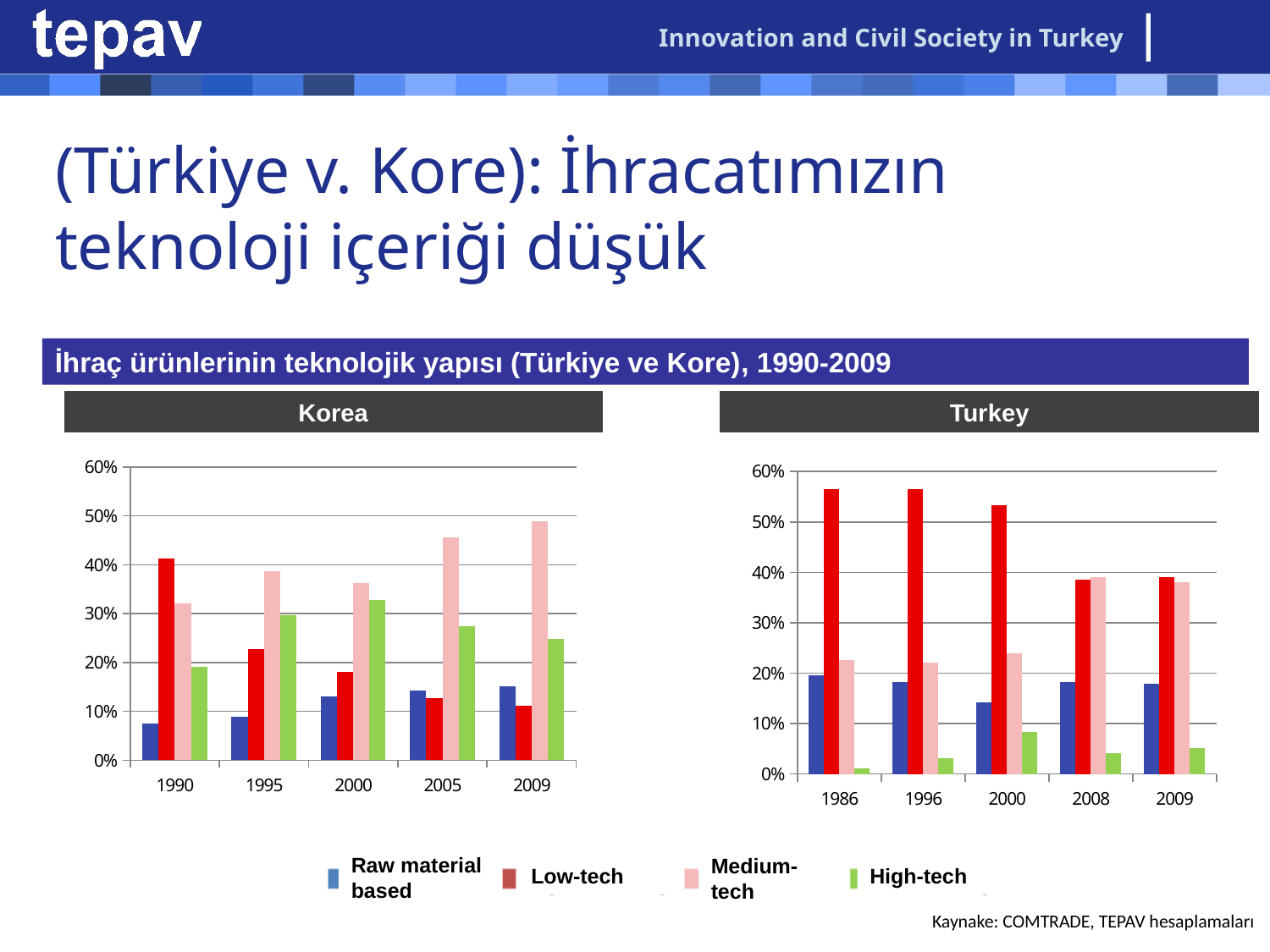
What kind of chart is the Korea chart? bar chart In the Korea chart, does the Low-tech share rise or fall from 1990 to 2009? fall In the Turkey chart, is the Low-tech value for 1986 greater or less than 50%? greater In the Korea chart, does the Medium-tech share rise or fall from 1990 to 2009? rise How many series does the legend list for the charts? 4 How many years are shown on the x axis of the Korea chart? 5 What is the title printed above the two charts? İhraç ürünlerinin teknolojik yapısı (Türkiye ve Kore), 1990-2009 In the Turkey chart, is the High-tech value for 1986 greater or less than 10%? less In the Korea chart, which is larger in 1990, Low-tech or High-tech? Low-tech In the Korea chart, which year has the highest Medium-tech value? 2009 In the Korea chart, is the Low-tech value for 1990 greater or less than 30%? greater In the Turkey chart, which series has the highest value in 2000? Low-tech